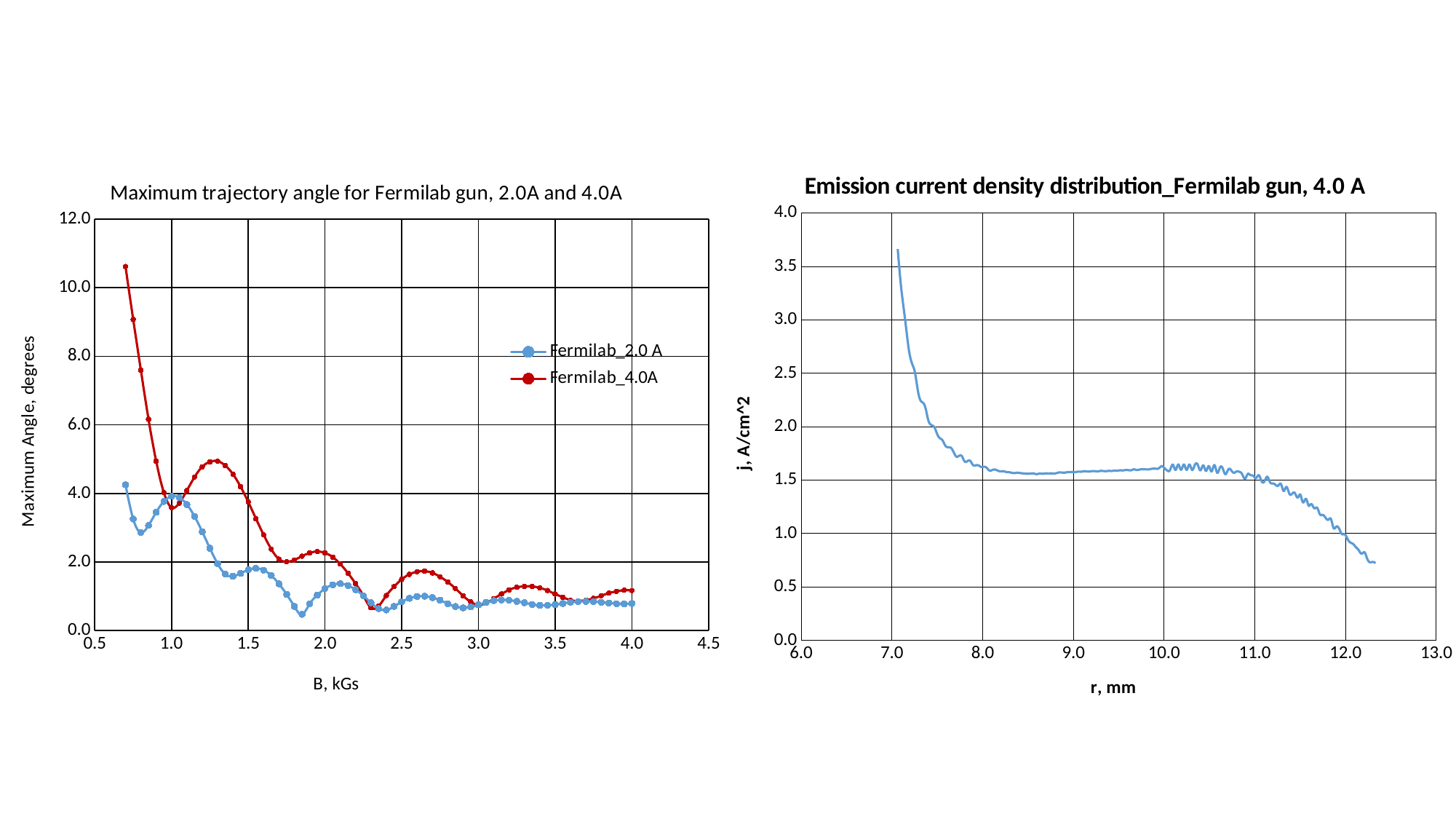
In the 'Emission current density distribution_Fermilab gun, 4.0 A' chart, is the value at r = 7.1 mm greater or less than 3.0? greater In the 'Maximum trajectory angle for Fermilab gun, 2.0A and 4.0A' chart, which series has the higher value at B = 0.7 kGs? Fermilab_4.0A In the 'Maximum trajectory angle for Fermilab gun, 2.0A and 4.0A' chart, is the value of Fermilab_4.0A at B = 0.7 kGs greater or less than 10.0? greater In the 'Maximum trajectory angle for Fermilab gun, 2.0A and 4.0A' chart, is the value of Fermilab_2.0 A at B = 1.85 kGs greater or less than 1.0? less What is the x-axis title of the 'Emission current density distribution_Fermilab gun, 4.0 A' chart? r, mm How many series does the legend of the 'Maximum trajectory angle for Fermilab gun, 2.0A and 4.0A' chart list? 2 What kind of chart is the 'Maximum trajectory angle for Fermilab gun, 2.0A and 4.0A' chart? line chart In the 'Maximum trajectory angle for Fermilab gun, 2.0A and 4.0A' chart, does the Fermilab_4.0A series overall rise or fall as B increases from 0.7 to 4.0 kGs? fall In the 'Maximum trajectory angle for Fermilab gun, 2.0A and 4.0A' chart, which series has the higher value at B = 1.3 kGs? Fermilab_4.0A What is the y-axis title of the 'Maximum trajectory angle for Fermilab gun, 2.0A and 4.0A' chart? Maximum Angle, degrees